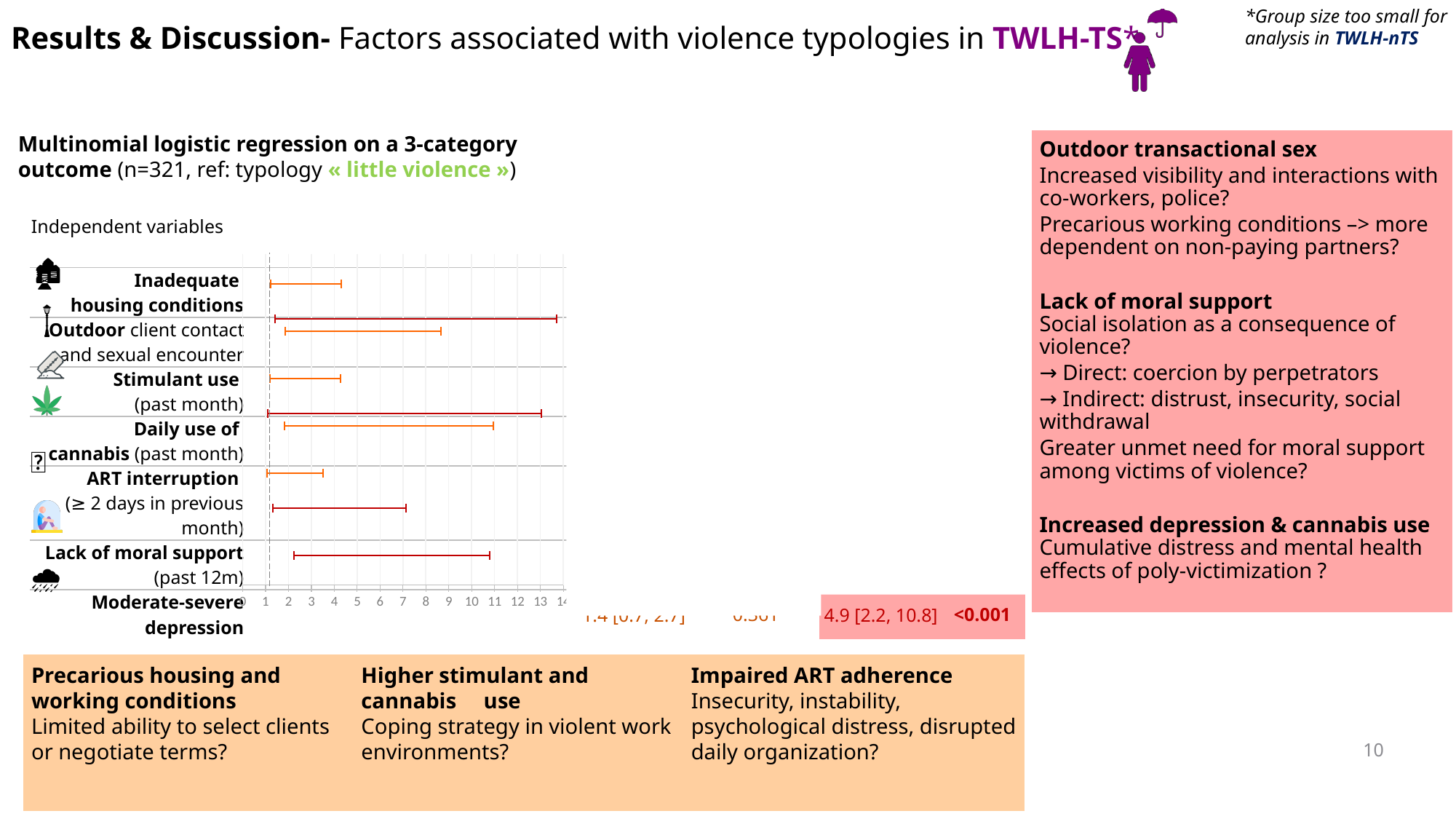
What kind of chart is shown on the slide? Forest plot (horizontal error bar chart) Does the longest dark red bar extend to a value greater or less than 13 on the x axis? greater Is the upper end of the orange bar for Inadequate housing conditions greater or less than 5? less How many independent variables are listed on the chart? 7 What is the highest tick value shown on the chart's x axis? 14 How many differently coloured series of bars does the chart show? 2 Is the upper end of the orange bar for ART interruption greater or less than 4? less At what x-axis value is the dashed vertical reference line drawn? 1